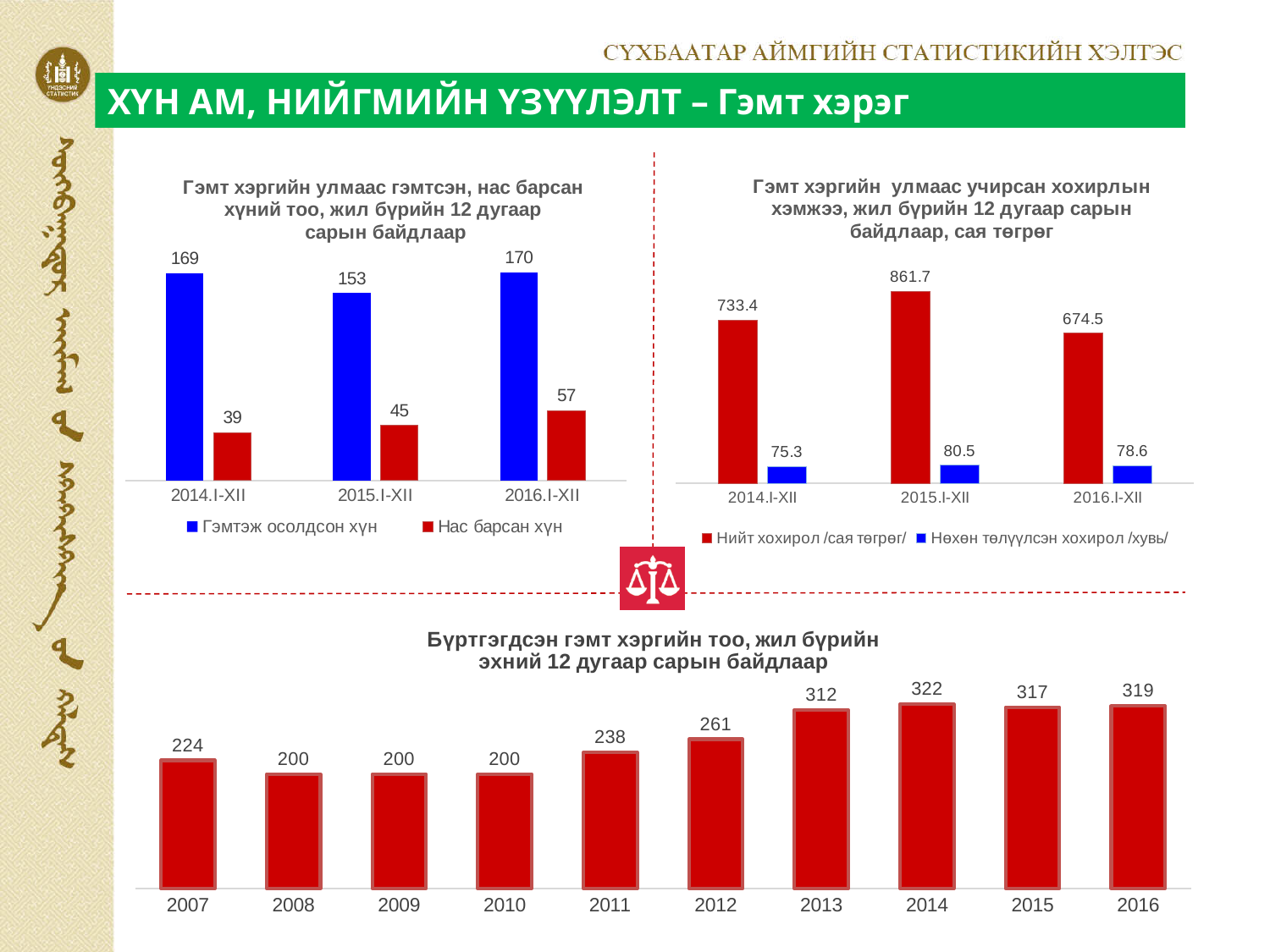
In the top-right chart, which year has the highest value for 'Нийт хохирол /сая төгрөг/'? 2015.I-XII In the bottom chart, which year has the highest value? 2014 What kind of chart is the bottom chart? Bar chart In the top-left chart, which year has the lowest value for 'Гэмтэж осолдсон хүн'? 2015.I-XII How many series does the legend of the top-left chart list? 2 In the top-left chart, what is the value for 'Нас барсан хүн' in 2016.I-XII? 57 How many years are shown on the x axis of the bottom chart? 10 In the bottom chart, what is the value for 2013? 312 In the top-right chart, is the value for 'Нөхөн төлүүлсэн хохирол /хувь/' larger in 2014.I-XII or 2016.I-XII? 2016.I-XII In the top-right chart, what is the value for 'Нийт хохирол /сая төгрөг/' in 2015.I-XII? 861.7 In the top-left chart, what is the difference between 'Гэмтэж осолдсон хүн' and 'Нас барсан хүн' in 2014.I-XII? 130 In the bottom chart, what is the difference between the values for 2016 and 2007? 95